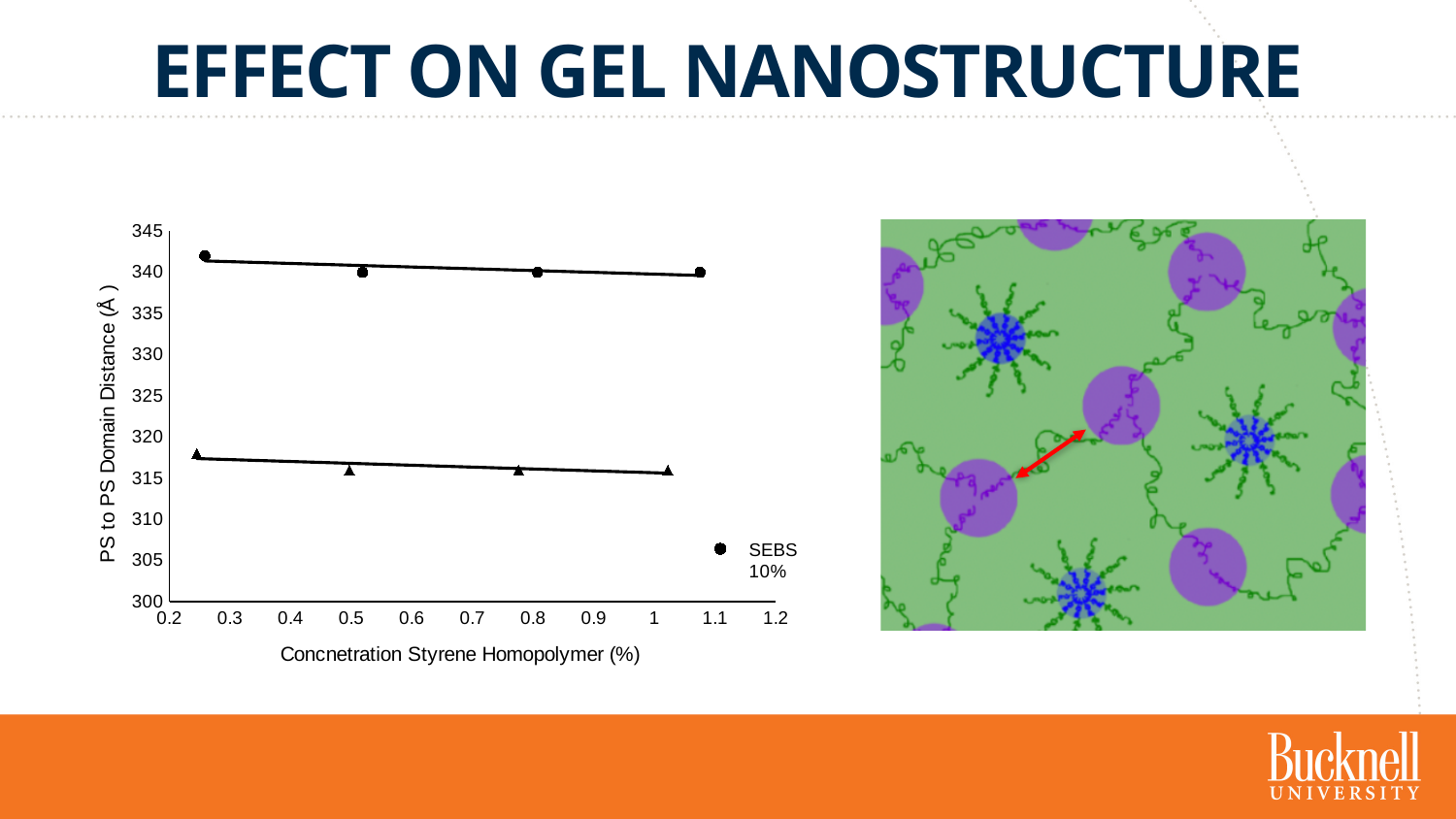
How many data points are plotted for the SEBS 10% (circle) series? 4 Is the value for the SEBS 10% series at a concentration of about 1.1% greater or less than 330? greater What kind of chart is shown on the left of the slide? scatter chart Is the value for the SEBS 10% series at a concentration of about 0.25% greater or less than 335? greater Do the values of the SEBS 10% series rise or fall as the concentration of styrene homopolymer increases? fall How many data points are plotted for the triangle series? 4 Is the value for the triangle series at a concentration of about 0.5% greater or less than 320? less How many series does the chart legend list? 1 Which series has the higher PS to PS domain distance values, the SEBS 10% circles or the triangles? SEBS 10% (circles) What is the label of the x axis of the chart? Concnetration Styrene Homopolymer (%) What is the legend entry shown on the chart? SEBS 10%